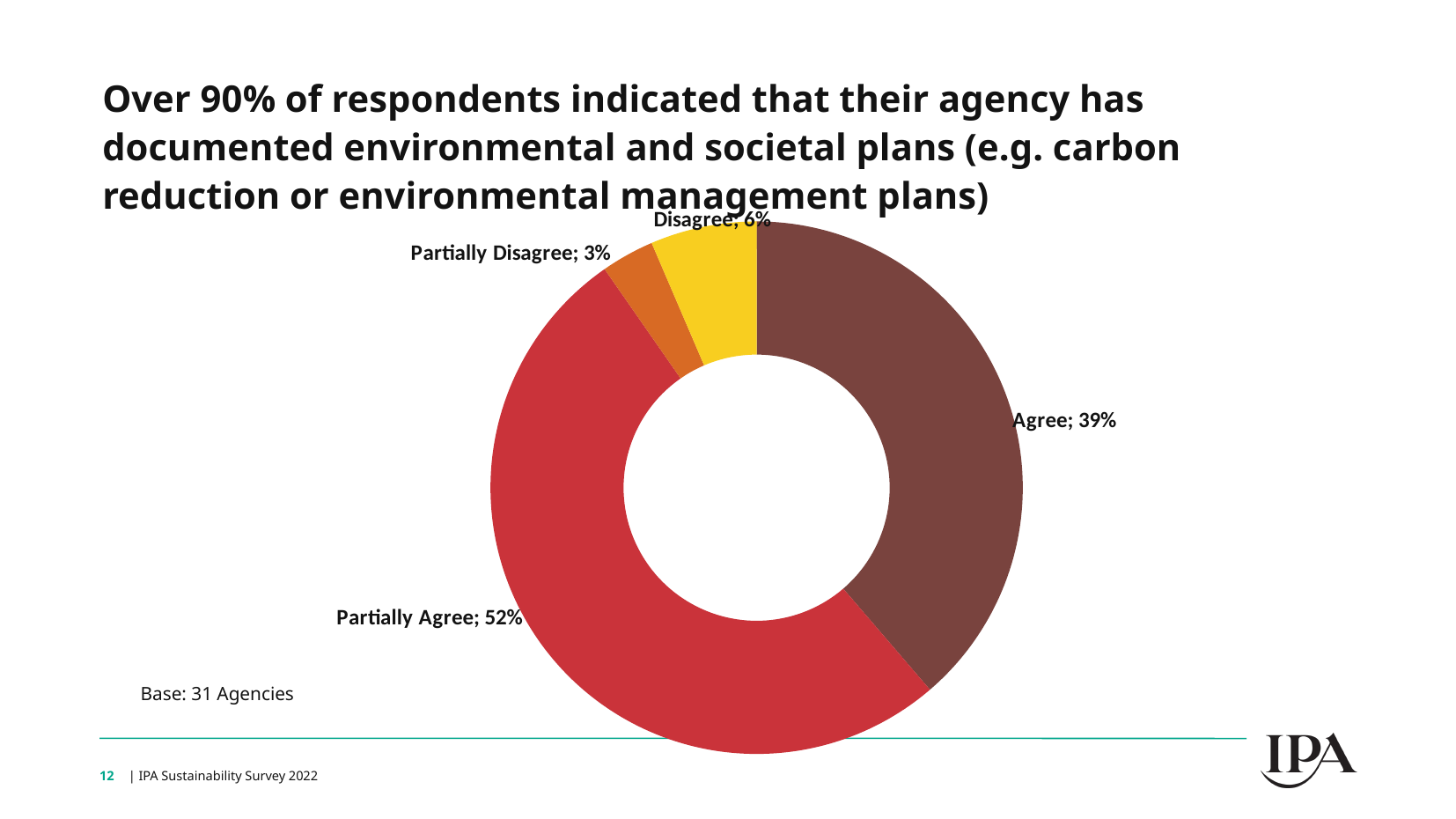
What is the combined share of 'Agree' and 'Partially Agree'? 91% What percentage of respondents answered 'Partially Disagree'? 3% What kind of chart is shown on the slide? Doughnut (pie) chart What percentage of respondents answered 'Agree'? 39% Which response category has the largest share? Partially Agree What is the base (number of agencies) stated for the chart? 31 Agencies What is the difference in percentage points between 'Partially Agree' and 'Agree'? 13 How many response categories are shown in the chart? 4 What percentage of respondents answered 'Disagree'? 6% Which response category has the smallest share? Partially Disagree What percentage of respondents answered 'Partially Agree'? 52% Which is larger, the share for 'Disagree' or the share for 'Partially Disagree'? Disagree